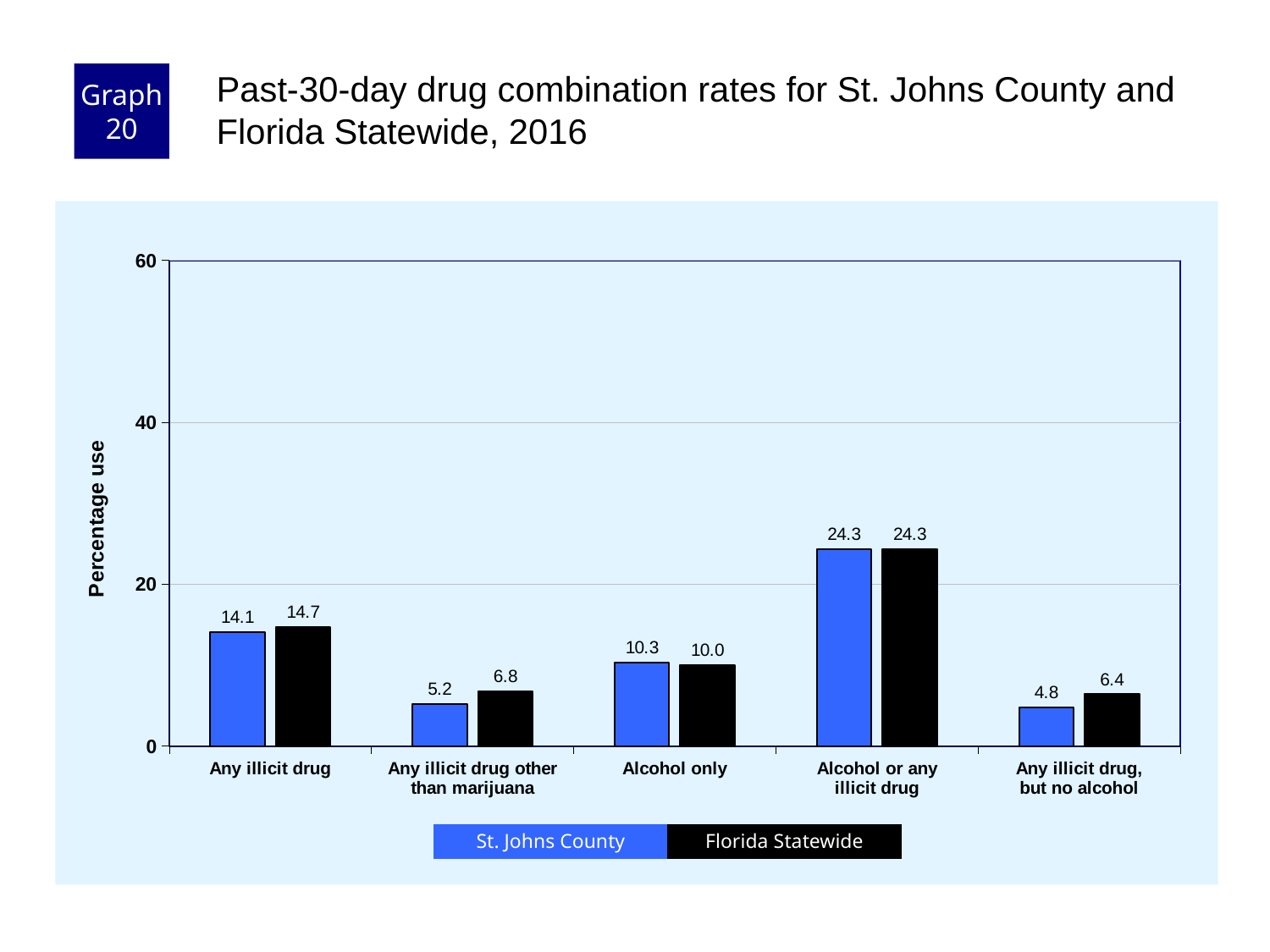
What kind of chart is shown on the slide? bar chart Which is larger for Any illicit drug other than marijuana: St. Johns County or Florida Statewide? Florida Statewide Which category has the highest St. Johns County value? Alcohol or any illicit drug What is the St. Johns County value for Alcohol only? 10.3 How many series does the legend list? 2 What is the difference between the Florida Statewide and St. Johns County values for Any illicit drug, but no alcohol? 1.6 Which category has the lowest Florida Statewide value? Any illicit drug, but no alcohol What is the label of the y axis? Percentage use How many categories are shown on the x axis? 5 What is the St. Johns County value for Any illicit drug? 14.1 What is the Florida Statewide value for Any illicit drug other than marijuana? 6.8 Is the Florida Statewide value for Alcohol or any illicit drug greater or less than 20? greater